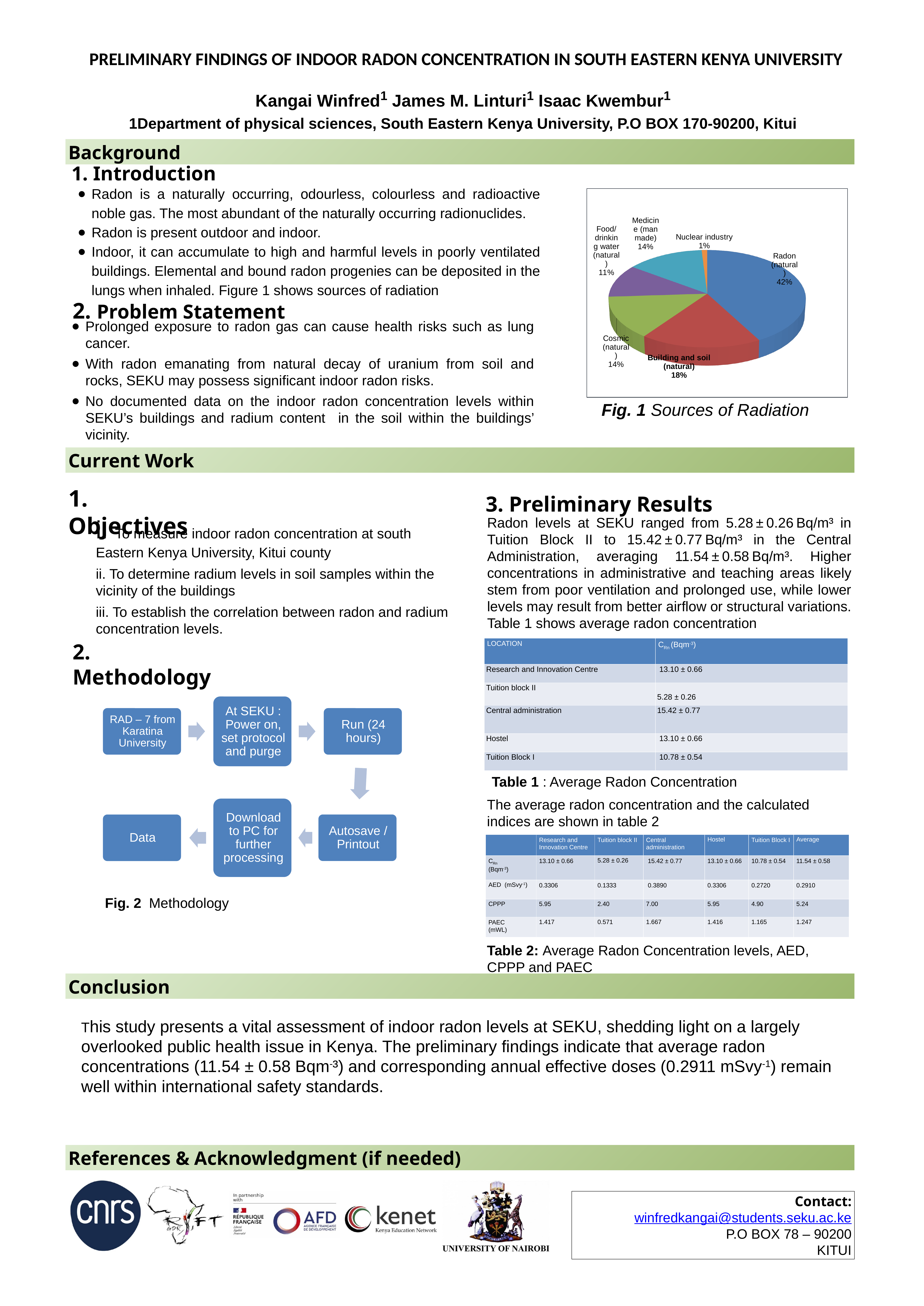
In the Sources of Radiation pie chart, what percentage is shown for Building and soil (natural)? 18% In the Sources of Radiation pie chart, what percentage is shown for Nuclear industry? 1% Which source has the smallest slice in the Sources of Radiation pie chart? Nuclear industry In the Sources of Radiation pie chart, what percentage is shown for Food/drinking water (natural)? 11% What kind of chart is Fig. 1 Sources of Radiation? Pie chart In the Sources of Radiation pie chart, what share is attributed to Radon (natural)? 42% How many sources (slices) are shown in the Sources of Radiation pie chart? 6 In the Sources of Radiation pie chart, what is the difference in percentage points between Radon (natural) and Building and soil (natural)? 24 percentage points In the Sources of Radiation pie chart, what is the combined share of Radon (natural) and Building and soil (natural)? 60% Which source has the largest slice in the Sources of Radiation pie chart? Radon (natural) In the Sources of Radiation pie chart, which is larger: Building and soil (natural) or Food/drinking water (natural)? Building and soil (natural) In the Sources of Radiation pie chart, what percentage is shown for Medicine (man made)? 14%